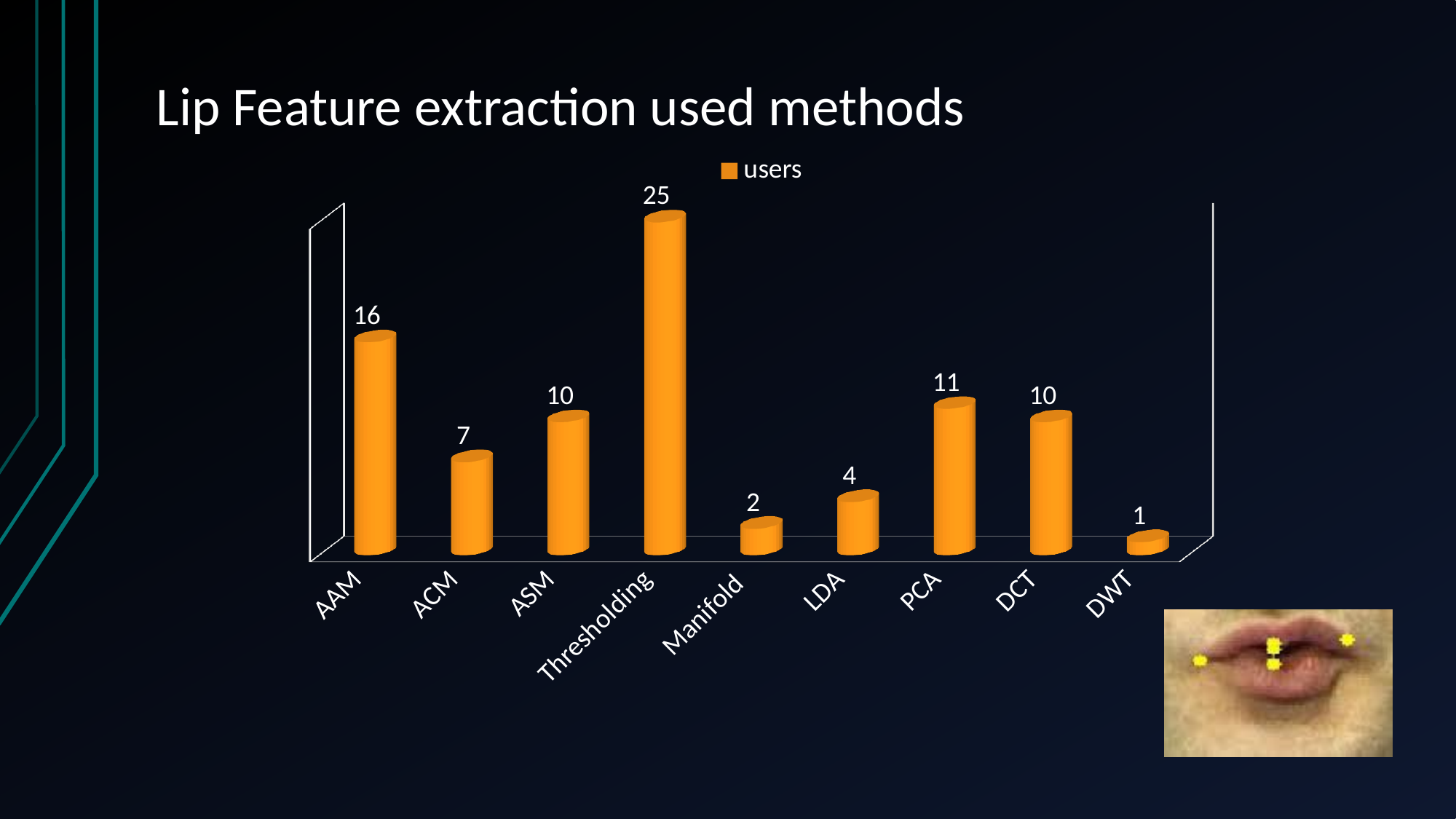
What is the value for Thresholding? 25 What kind of chart is shown on the slide? Bar chart Which method has the lowest number of users? DWT What is the difference between the values for Thresholding and AAM? 9 What is the difference between the values for PCA and ACM? 4 How many users does the chart show for AAM? 16 How many series does the legend list? 1 How many methods are shown on the x axis? 9 What is the name of the series in the legend? users Which method has the highest number of users? Thresholding What is the value for PCA? 11 Which has more users, LDA or Manifold? LDA